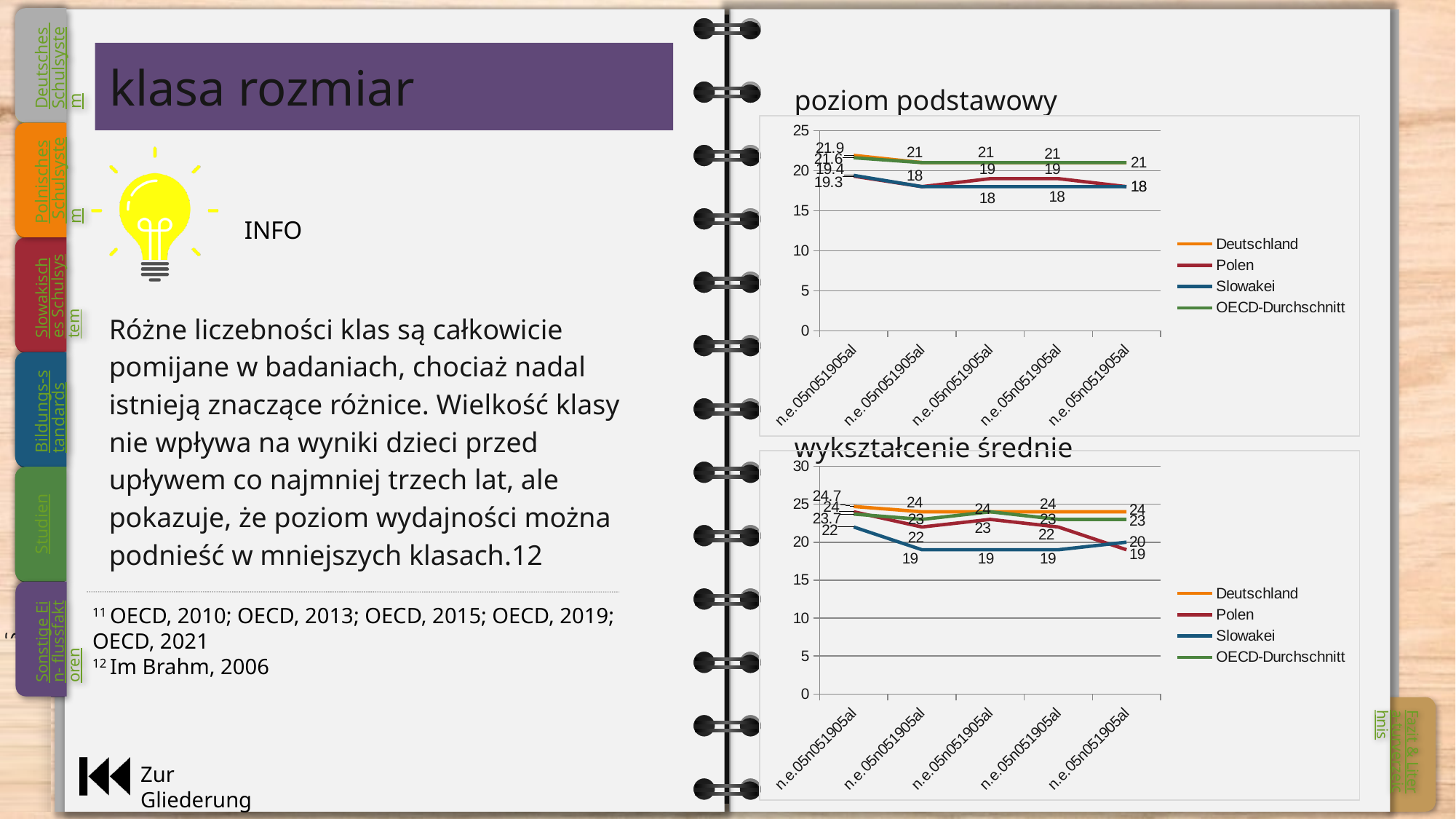
In the 'wykształcenie średnie' chart, what is the value for Slowakei at the last point? 20 How many data points does each series have in the 'wykształcenie średnie' chart? 5 In the 'poziom podstawowy' chart, which is larger at the last point, Deutschland or Slowakei? Deutschland In the 'wykształcenie średnie' chart, what is the value for Deutschland at the last point? 24 What kind of chart is the 'poziom podstawowy' chart? line chart In the 'poziom podstawowy' chart, what is the value for Slowakei at the last point? 18 In the 'wykształcenie średnie' chart, which series has the lowest value at the last point? Polen In the 'wykształcenie średnie' chart, what is the difference between Deutschland and Polen at the last point? 5 In the 'poziom podstawowy' chart, what is the value for Deutschland at the last point? 21 In the 'wykształcenie średnie' chart, which series is drawn in green? OECD-Durchschnitt In the 'wykształcenie średnie' chart, what is the value for Polen at the last point? 19 How many series does the legend of the 'poziom podstawowy' chart list? 4